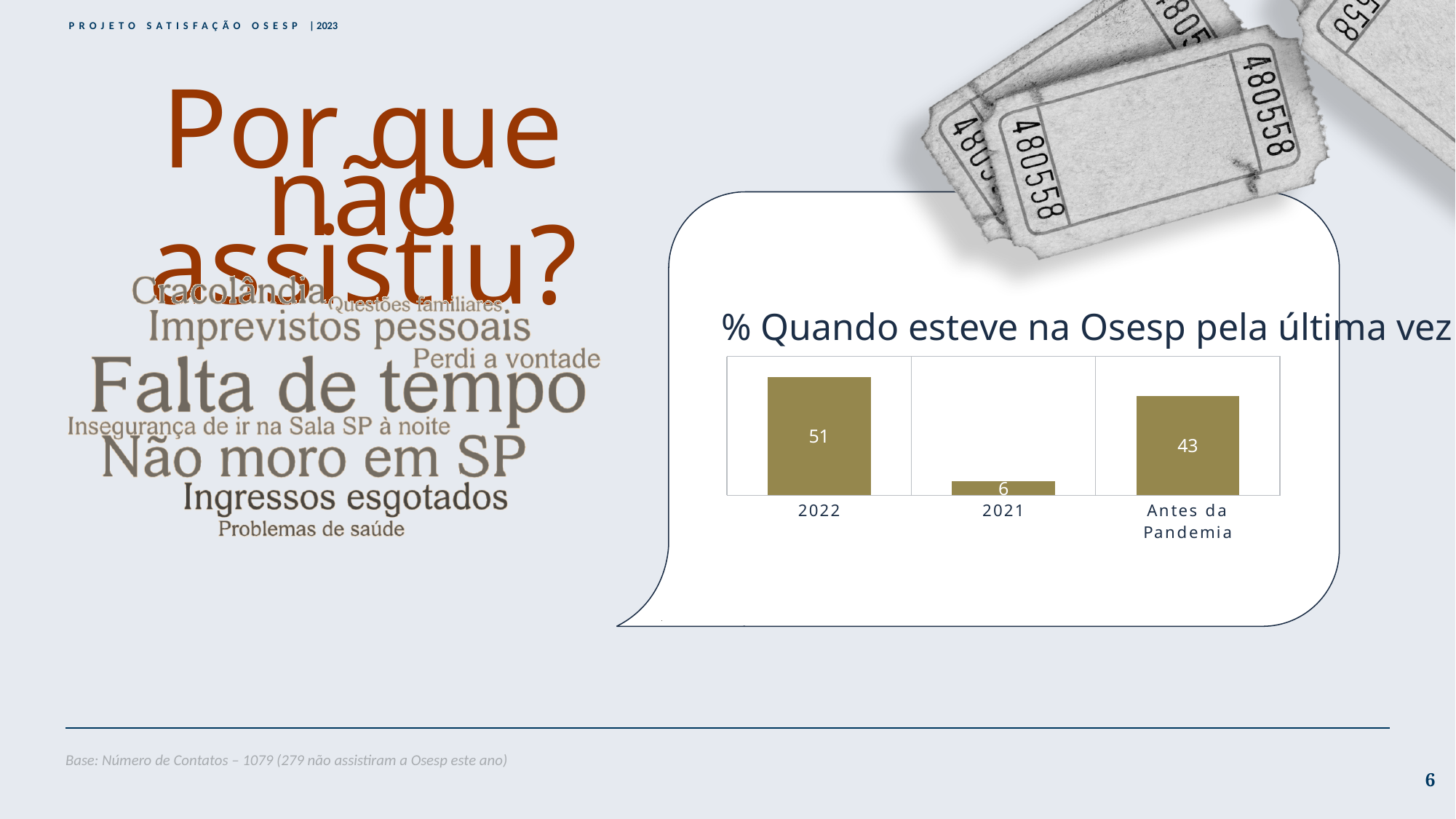
Which category has the highest value in the chart? 2022 What is the title of the chart on the slide? % Quando esteve na Osesp pela última vez What is the value for 'Antes da Pandemia' in the chart? 43 What is the value for 2022 in the chart '% Quando esteve na Osesp pela última vez'? 51 What is the value for 2021 in the chart? 6 What is the difference between the values for 2022 and 2021? 45 How many categories are shown in the chart? 3 What kind of chart is shown on the slide? Bar chart Which category has the lowest value in the chart? 2021 Which is larger, the value for 2021 or the value for 'Antes da Pandemia'? Antes da Pandemia What is the difference between the values for 2022 and 'Antes da Pandemia'? 8 What is the total of the three values shown in the chart? 100